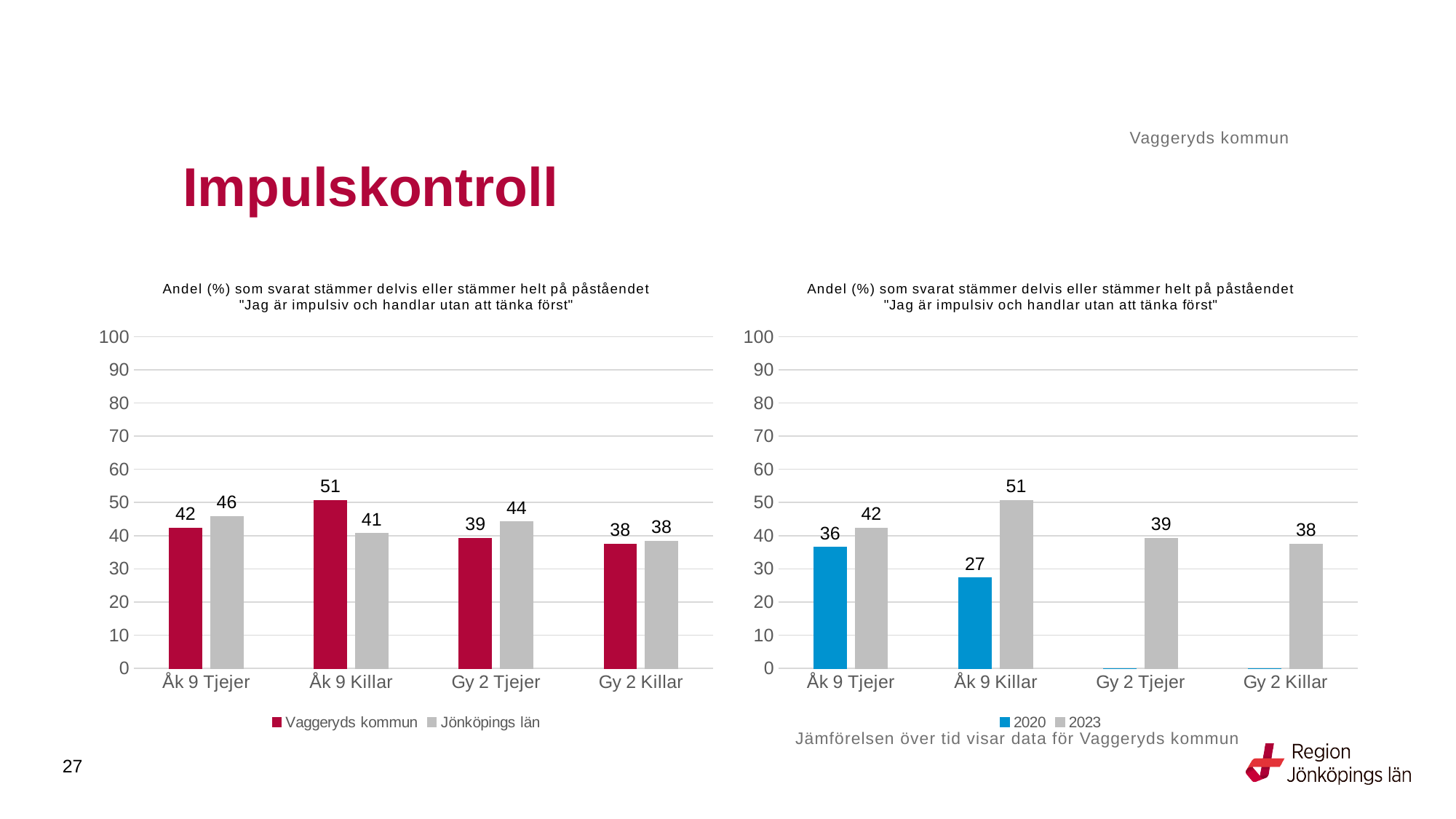
What kind of chart is the left chart? Bar chart In the left chart, which category has the lowest value for Jönköpings län? Gy 2 Killar In the left chart, what is the value for Vaggeryds kommun for Åk 9 Killar? 51 In the left chart, which category has the highest value for Vaggeryds kommun? Åk 9 Killar In the right chart, what is the value for 2020 for Åk 9 Killar? 27 In the right chart, what is the value for 2023 for Gy 2 Tjejer? 39 In the right chart, which category has the highest value for 2023? Åk 9 Killar In the left chart, which is larger for Åk 9 Tjejer: Vaggeryds kommun or Jönköpings län? Jönköpings län In the left chart, what is the difference between Vaggeryds kommun and Jönköpings län for Åk 9 Killar? 10 In the right chart, what is the difference between 2023 and 2020 for Åk 9 Killar? 24 How many series does the legend of the right chart list? 2 In the left chart, what is the value for Jönköpings län for Gy 2 Tjejer? 44